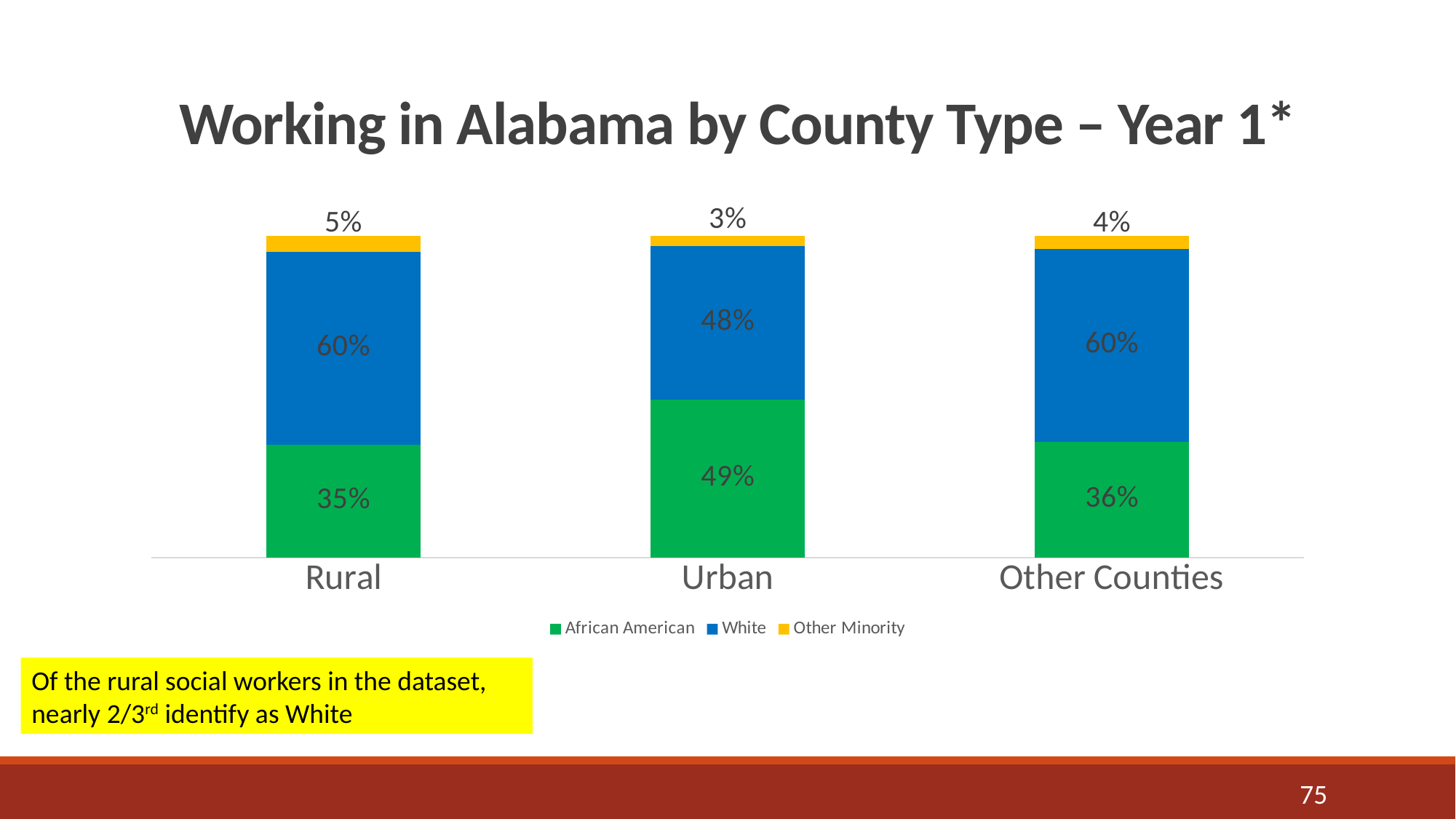
What kind of chart is shown on the slide? Stacked bar chart What percentage of the Urban bar is African American? 49% Is the African American percentage larger for Urban or for Rural? Urban What is the total of the Urban stacked bar? 100% What is the Other Minority value for Other Counties? 4% How many county types are shown on the x axis? 3 What percentage of the Rural bar is White? 60% Which colour represents the White series in the legend? Blue What is the difference between the White percentage for Rural and for Urban? 12% How many series does the legend list? 3 Which county type has the highest African American percentage? Urban Which county type has the lowest Other Minority percentage? Urban